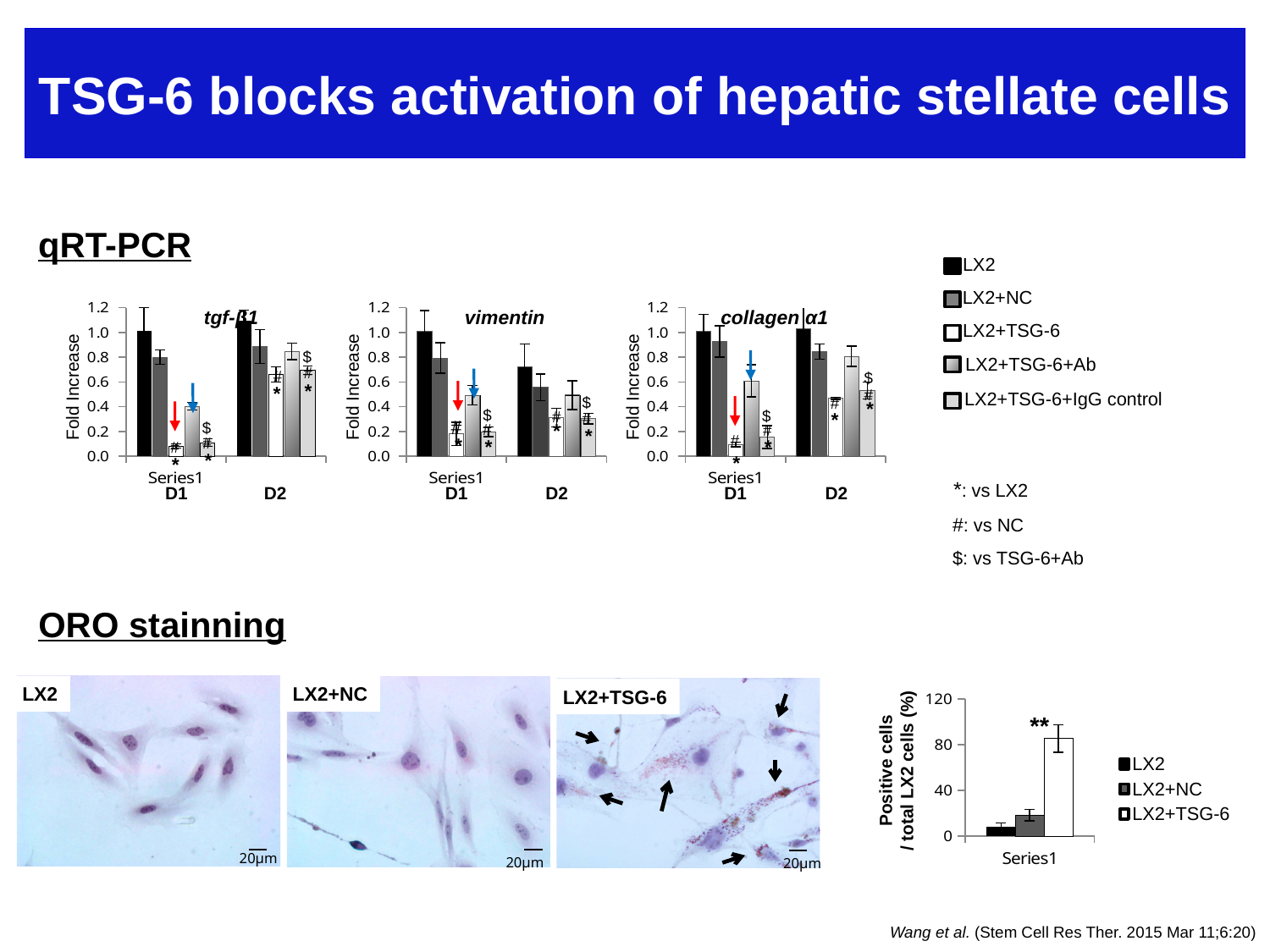
In the vimentin chart, is the value for LX2 at D2 greater or less than 0.4? greater In the ORO staining bar chart, what kind of chart is it? bar chart In the ORO staining bar chart, which group has the lowest percentage of positive cells? LX2 How many series does the shared legend for the qRT-PCR charts list? 5 In the ORO staining bar chart, how many series does the legend list? 3 In the ORO staining bar chart, is the value for LX2+TSG-6 greater or less than 40? greater In the tgf-β1 chart, how many time-point groups (D1, D2) are shown on the x axis? 2 In the tgf-β1 chart, is the value for LX2+TSG-6 at D1 greater or less than 0.4? less In the ORO staining bar chart, what is the y-axis label? Positive cells / total LX2 cells (%) In the vimentin chart, which is larger at D1: LX2 or LX2+TSG-6? LX2 In the collagen α1 chart, which is larger at D1: LX2+TSG-6 or LX2+TSG-6+Ab? LX2+TSG-6+Ab In the ORO staining bar chart, which group has the highest percentage of positive cells? LX2+TSG-6